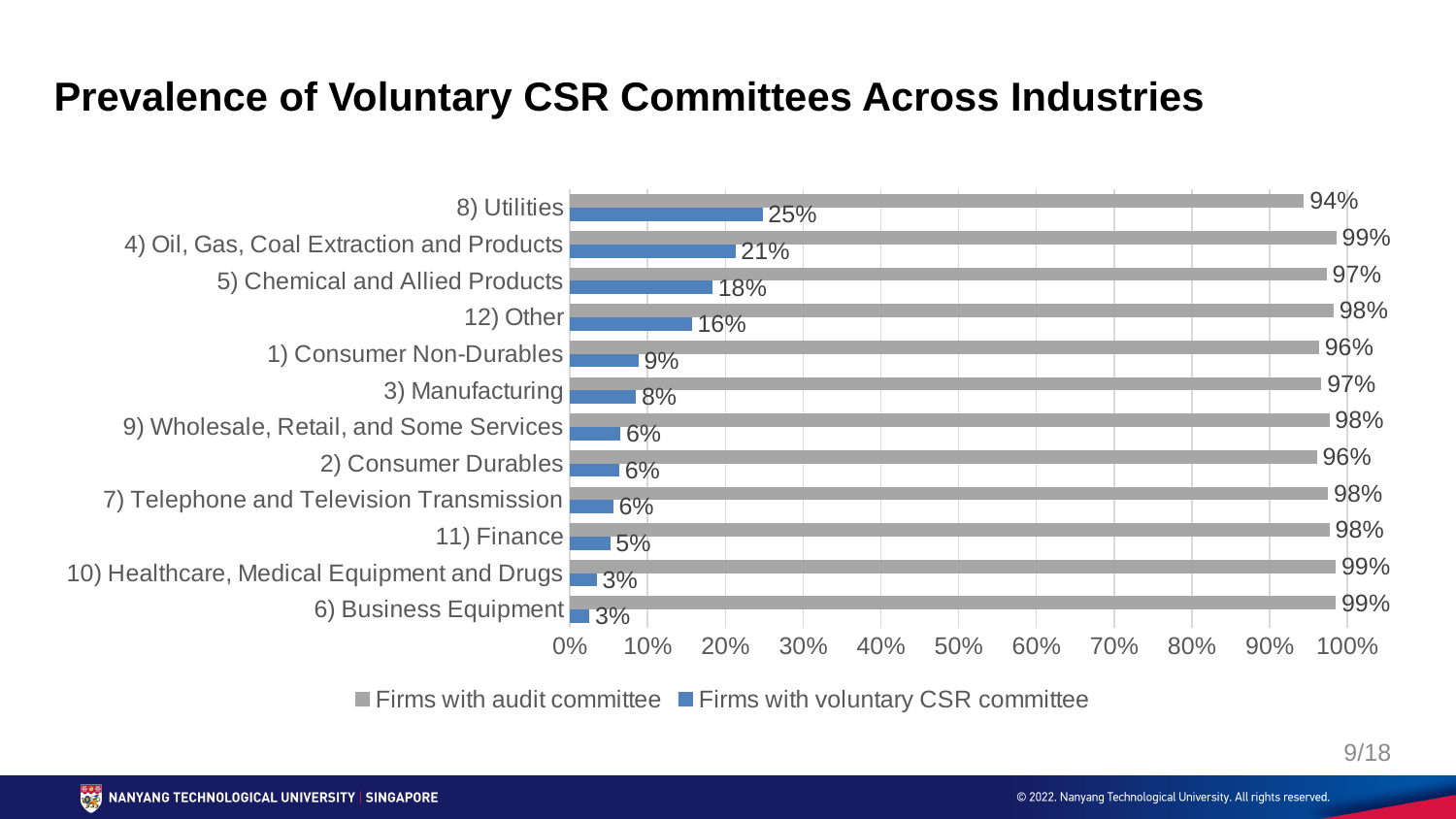
What percentage of firms in the Utilities industry have a voluntary CSR committee? 25% Is the share of firms with a voluntary CSR committee in Consumer Non-Durables greater or less than 10%? less What is the difference between the share of firms with an audit committee and the share with a voluntary CSR committee in the Manufacturing industry? 89% How many industries are shown on the chart? 12 How many series does the legend list? 2 Which is larger: the share of firms with a voluntary CSR committee in Oil, Gas, Coal Extraction and Products or in Other? 4) Oil, Gas, Coal Extraction and Products What is the title of the chart? Prevalence of Voluntary CSR Committees Across Industries Which series is shown in blue? Firms with voluntary CSR committee Which industry has the highest share of firms with a voluntary CSR committee? 8) Utilities What percentage of firms in the Finance industry have an audit committee? 98% What kind of chart is shown on the slide? Bar chart What percentage of firms in the Chemical and Allied Products industry have a voluntary CSR committee? 18%